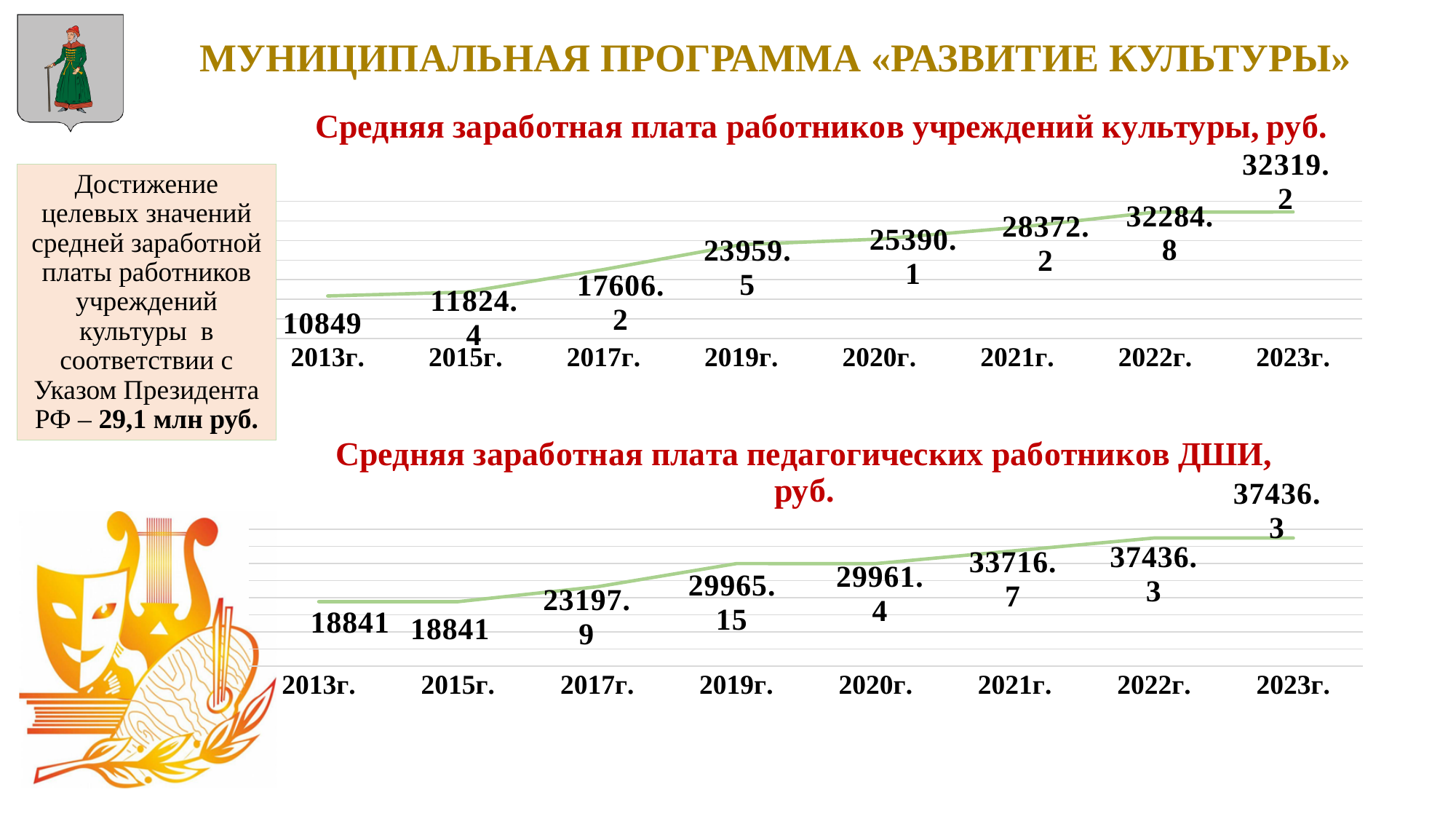
What type of chart is the bottom chart (Средняя заработная плата педагогических работников ДШИ)? Line chart In the bottom chart (Средняя заработная плата педагогических работников ДШИ), what is the value for 2017г.? 23197.9 In the top chart (Средняя заработная плата работников учреждений культуры), what is the value for 2021г.? 28372.2 In the bottom chart (Средняя заработная плата педагогических работников ДШИ), what is the difference between the values for 2022г. and 2021г.? 3719.6 In the top chart (Средняя заработная плата работников учреждений культуры), do the values generally rise or fall from 2013г. to 2023г.? Rise In the top chart (Средняя заработная плата работников учреждений культуры), how many years are plotted? 8 In the top chart (Средняя заработная плата работников учреждений культуры), what is the value for 2013г.? 10849 In the top chart (Средняя заработная плата работников учреждений культуры), what is the difference between the values for 2019г. and 2017г.? 6353.3 In the top chart (Средняя заработная плата работников учреждений культуры), which year has the highest value? 2023г. In the bottom chart (Средняя заработная плата педагогических работников ДШИ), what is the value for 2021г.? 33716.7 In the bottom chart (Средняя заработная плата педагогических работников ДШИ), which is larger, the value for 2019г. or 2020г.? 2019г. In the top chart (Средняя заработная плата работников учреждений культуры), which year has the lowest value? 2013г.